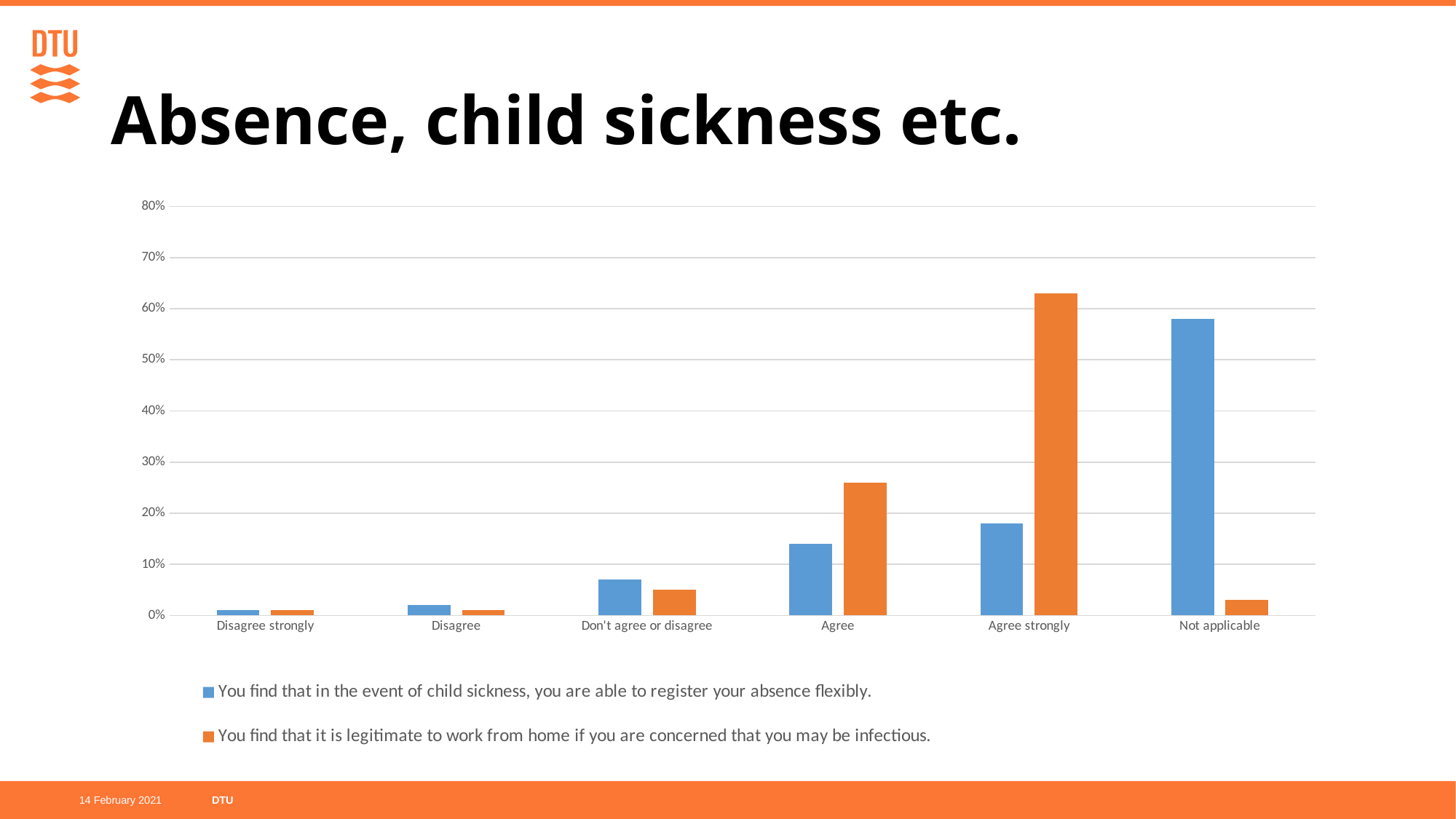
How many categories are shown on the x axis of the chart? 6 Is the value for 'Agree' in the series about working from home when concerned about being infectious greater or less than 20%? greater What kind of chart is shown on the slide? bar chart For the series 'You find that in the event of child sickness, you are able to register your absence flexibly.', which category has the highest value? Not applicable For the series 'You find that it is legitimate to work from home if you are concerned that you may be infectious.', which category has the highest value? Agree strongly For the 'Agree strongly' category, which series has the larger value? You find that it is legitimate to work from home if you are concerned that you may be infectious. Is the value for 'Not applicable' in the series about working from home when concerned about being infectious greater or less than 10%? less How many series does the legend list? 2 Is the value for 'Agree strongly' in the series about working from home when concerned about being infectious greater or less than 60%? greater What colour are the bars for the series 'You find that in the event of child sickness, you are able to register your absence flexibly.'? blue